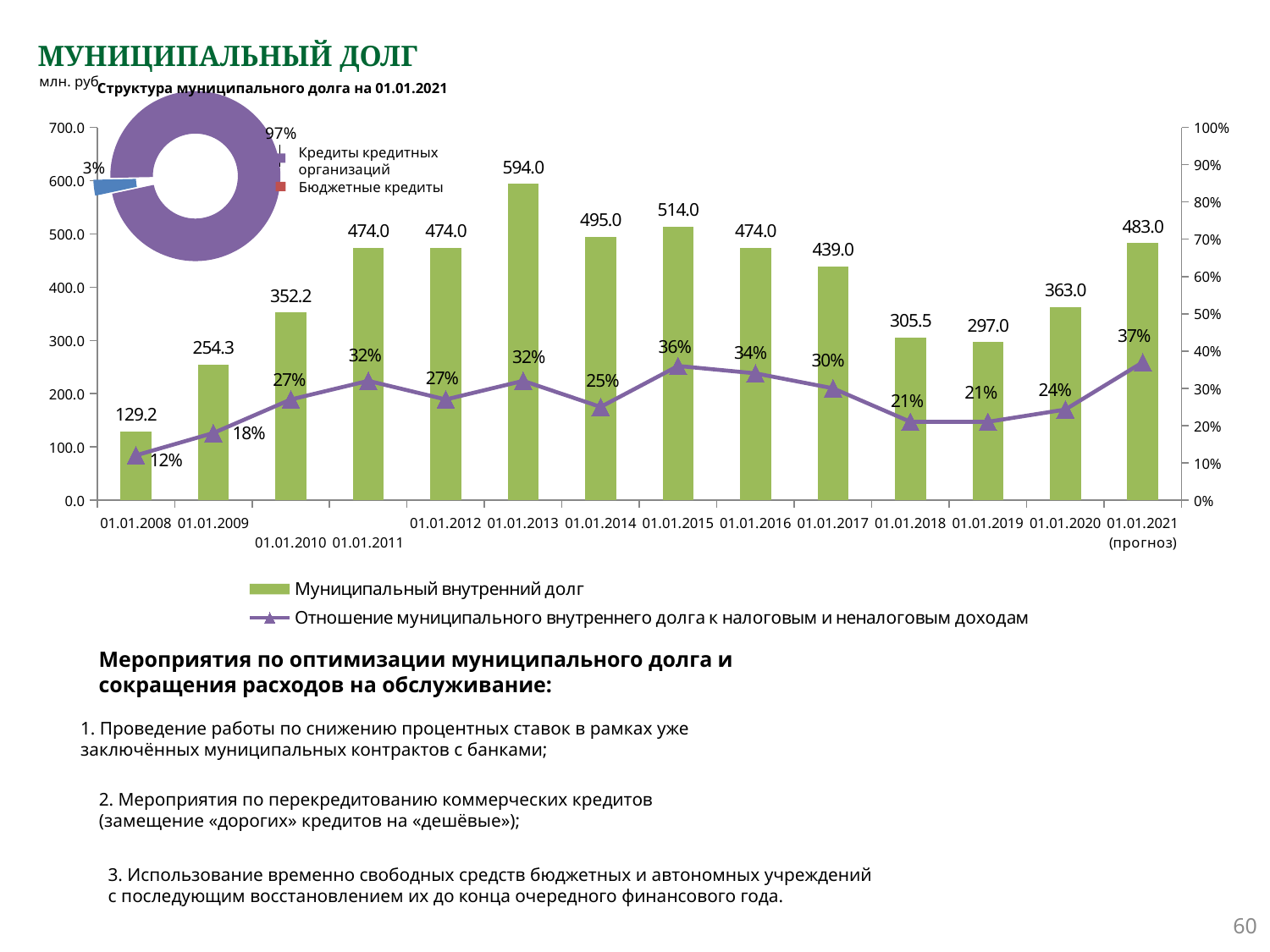
On the main bar-and-line chart, how many dates are shown on the x axis? 14 On the main bar-and-line chart, which date has the highest value of Муниципальный внутренний долг? 01.01.2013 On the chart titled Структура муниципального долга на 01.01.2021, what share is Кредиты кредитных организаций? 97% On the main bar-and-line chart, which date has the lowest value of Муниципальный внутренний долг? 01.01.2008 On the main bar-and-line chart, what is the lowest ratio value shown on the line series? 12% On the main bar-and-line chart, what is the difference between the Муниципальный внутренний долг values for 01.01.2013 and 01.01.2014? 99.0 On the main bar-and-line chart, what is the value of Муниципальный внутренний долг for 01.01.2013? 594.0 On the main bar-and-line chart, how many series does the legend list? 2 On the main bar-and-line chart, what is the ratio of municipal internal debt to tax and non-tax revenues shown for 01.01.2021 (прогноз)? 37% What kind of chart is the small chart titled Структура муниципального долга на 01.01.2021? Donut (pie) chart On the main bar-and-line chart, what is the value of Муниципальный внутренний долг for 01.01.2008? 129.2 On the main bar-and-line chart, which is larger: the Муниципальный внутренний долг value for 01.01.2020 or for 01.01.2021 (прогноз)? 01.01.2021 (прогноз)